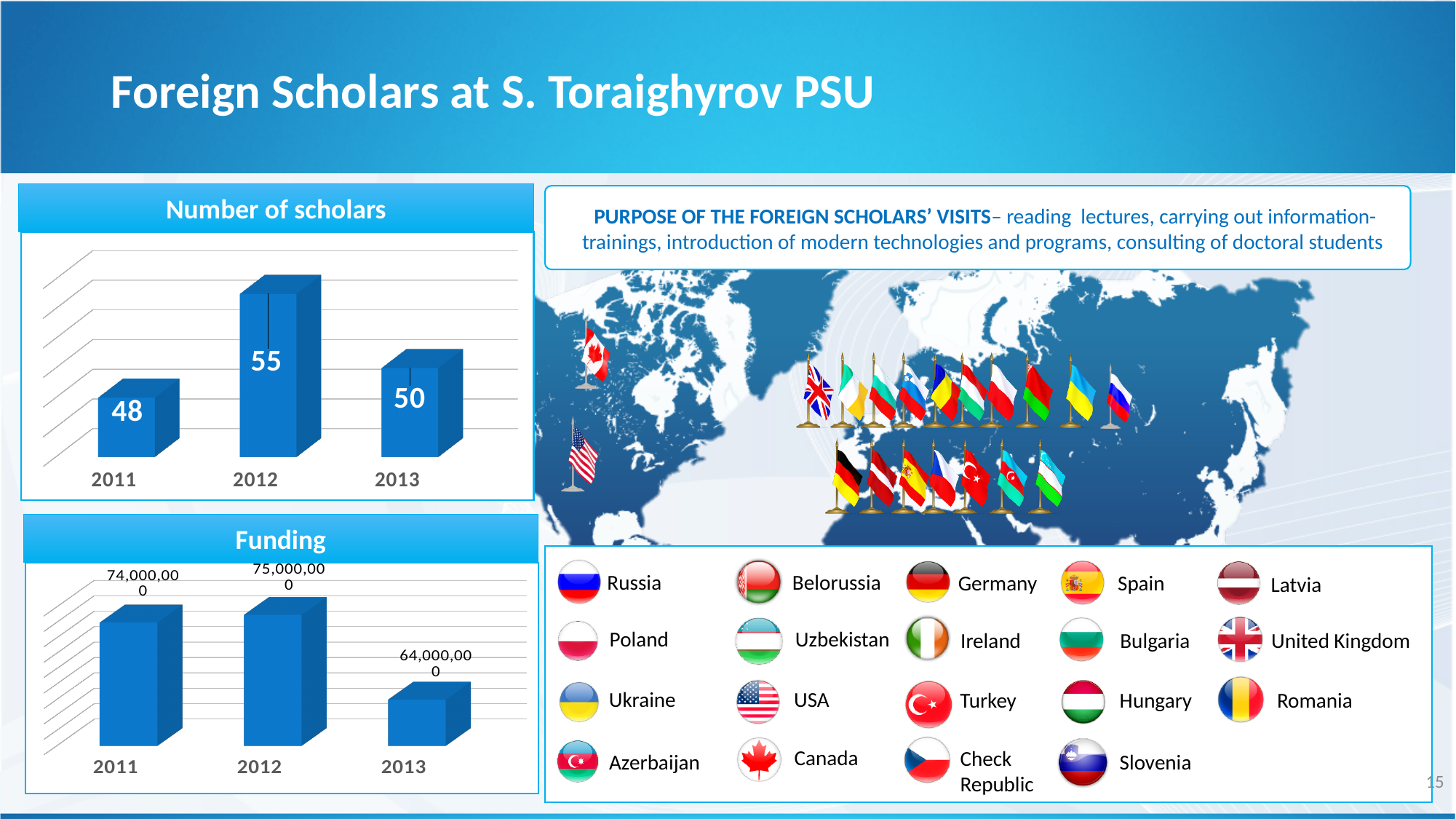
What kind of chart is the 'Number of scholars' chart? Bar chart In the 'Funding' chart, what is the value for 2012? 75,000,000 In the 'Number of scholars' chart, how many years are shown? 3 In the 'Number of scholars' chart, what is the value for 2012? 55 In the 'Funding' chart, which year has the lowest funding? 2013 In the 'Funding' chart, what is the value for 2013? 64,000,000 In the 'Number of scholars' chart, which year has the highest number of scholars? 2012 In the 'Number of scholars' chart, which year has the lowest number of scholars? 2011 In the 'Funding' chart, what is the difference between the funding for 2011 and 2013? 10,000,000 In the 'Funding' chart, is the value for 2012 larger or smaller than the value for 2013? Larger In the 'Number of scholars' chart, what is the difference between the values for 2012 and 2013? 5 In the 'Number of scholars' chart, what is the value for 2011? 48